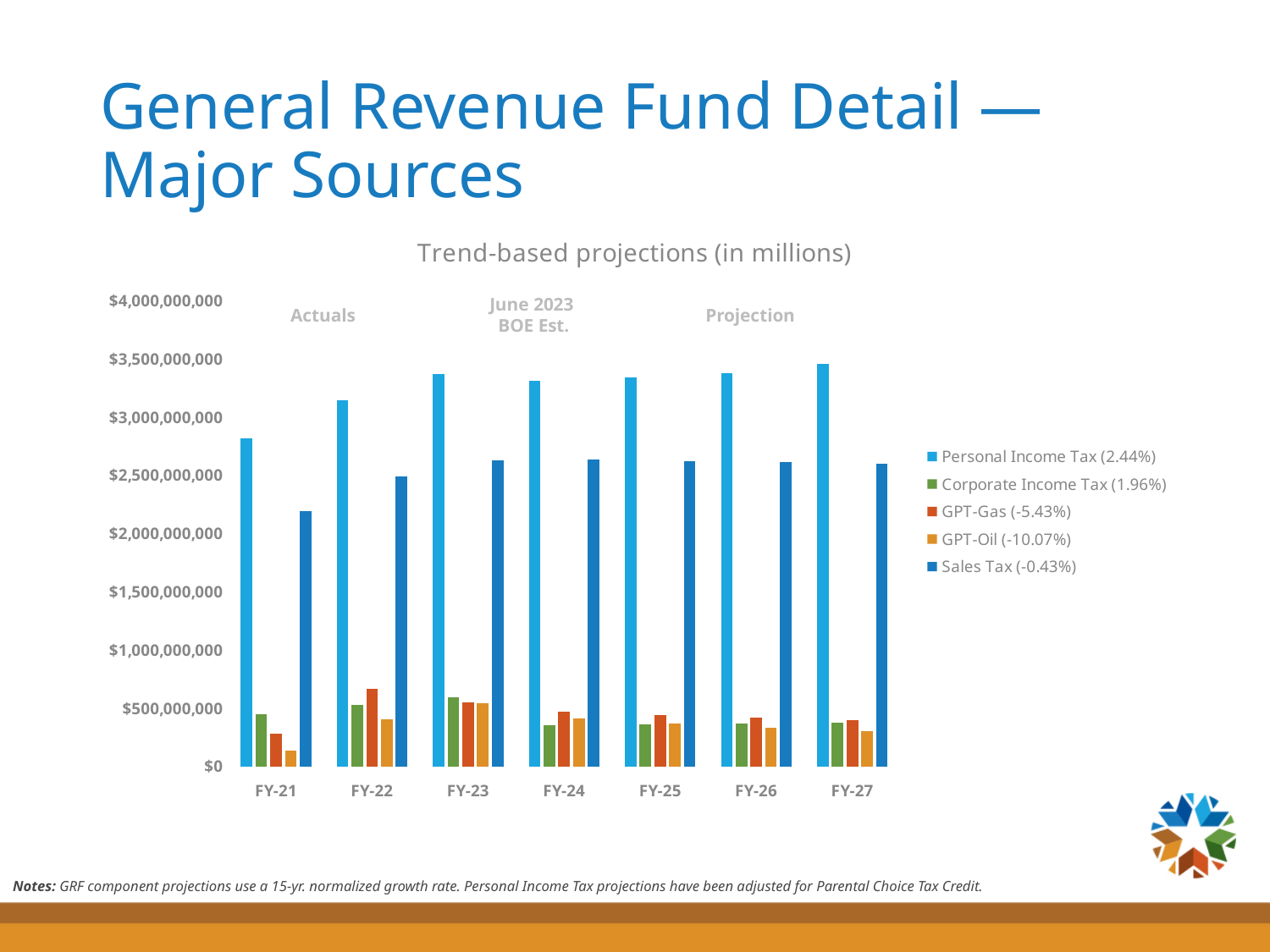
Do the Sales Tax values rise or fall from FY-21 to FY-23? rise Is the value for Sales Tax in FY-23 greater or less than $2,500,000,000? greater In which fiscal year is the Personal Income Tax bar the lowest? FY-21 Is the value for GPT-Gas in FY-22 greater or less than $500,000,000? greater Is the value for Personal Income Tax in FY-21 greater or less than $3,000,000,000? less In which fiscal year is the GPT-Oil bar the lowest? FY-21 In FY-21, which is larger: Personal Income Tax or Sales Tax? Personal Income Tax How many series does the legend list? 5 What kind of chart is shown on the slide? bar chart In which fiscal year is the GPT-Gas bar the highest? FY-22 How many fiscal years are shown on the x axis? 7